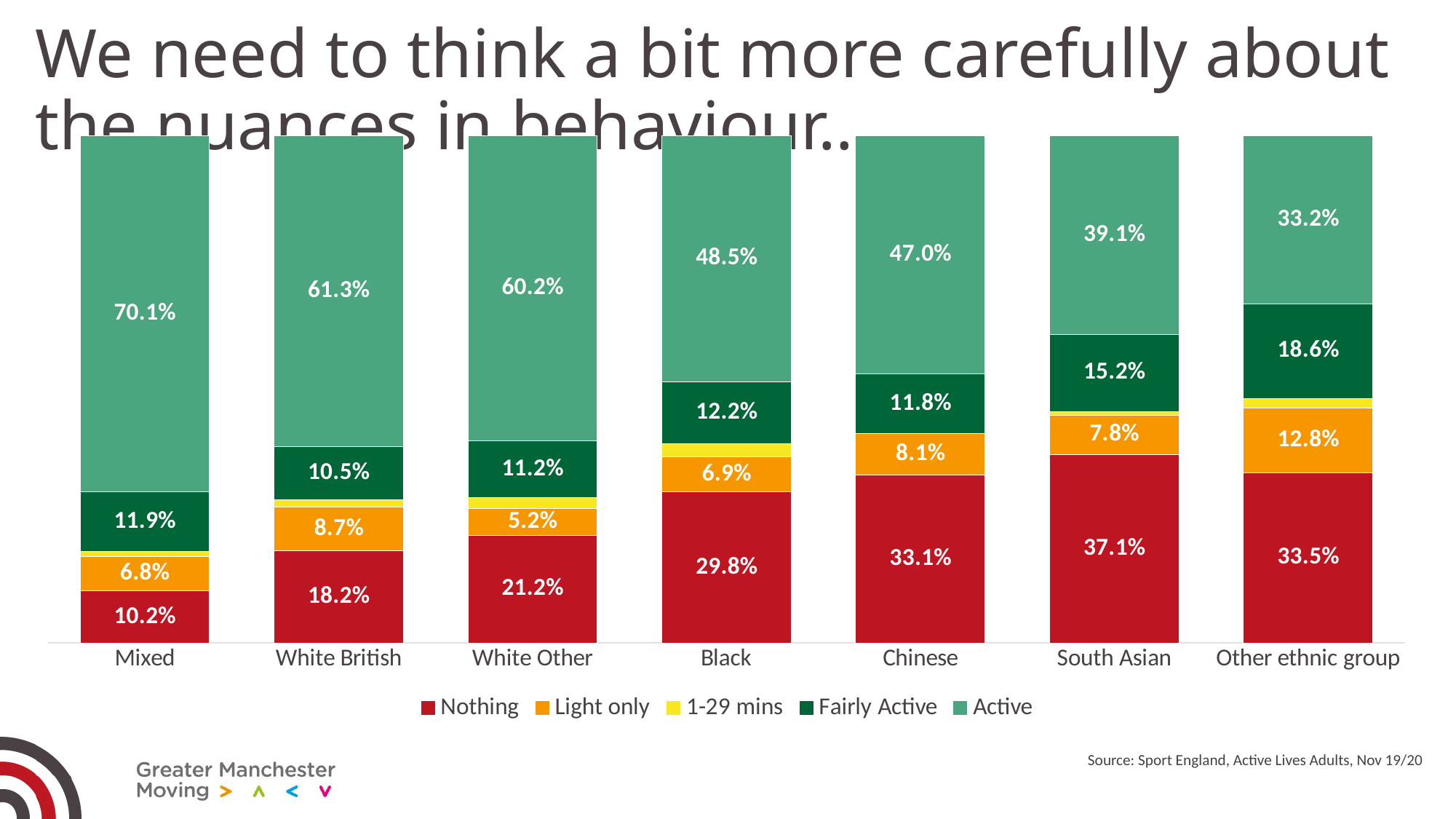
What is the Fairly Active value for Black? 12.2% What is the Light only value for Other ethnic group? 12.8% Which ethnic group has the lowest Nothing value? Mixed Which is larger, the Nothing value for Chinese or for Other ethnic group? Other ethnic group What is the Nothing value for South Asian? 37.1% Which legend entry is shown in yellow? 1-29 mins What is the difference between the Active values for White British and White Other? 1.1% Which ethnic group has the highest Active value? Mixed How many series does the legend list? 5 What is the Active value for the Mixed group? 70.1% How many ethnic groups are shown on the x axis? 7 What kind of chart is shown on the slide? Stacked bar chart